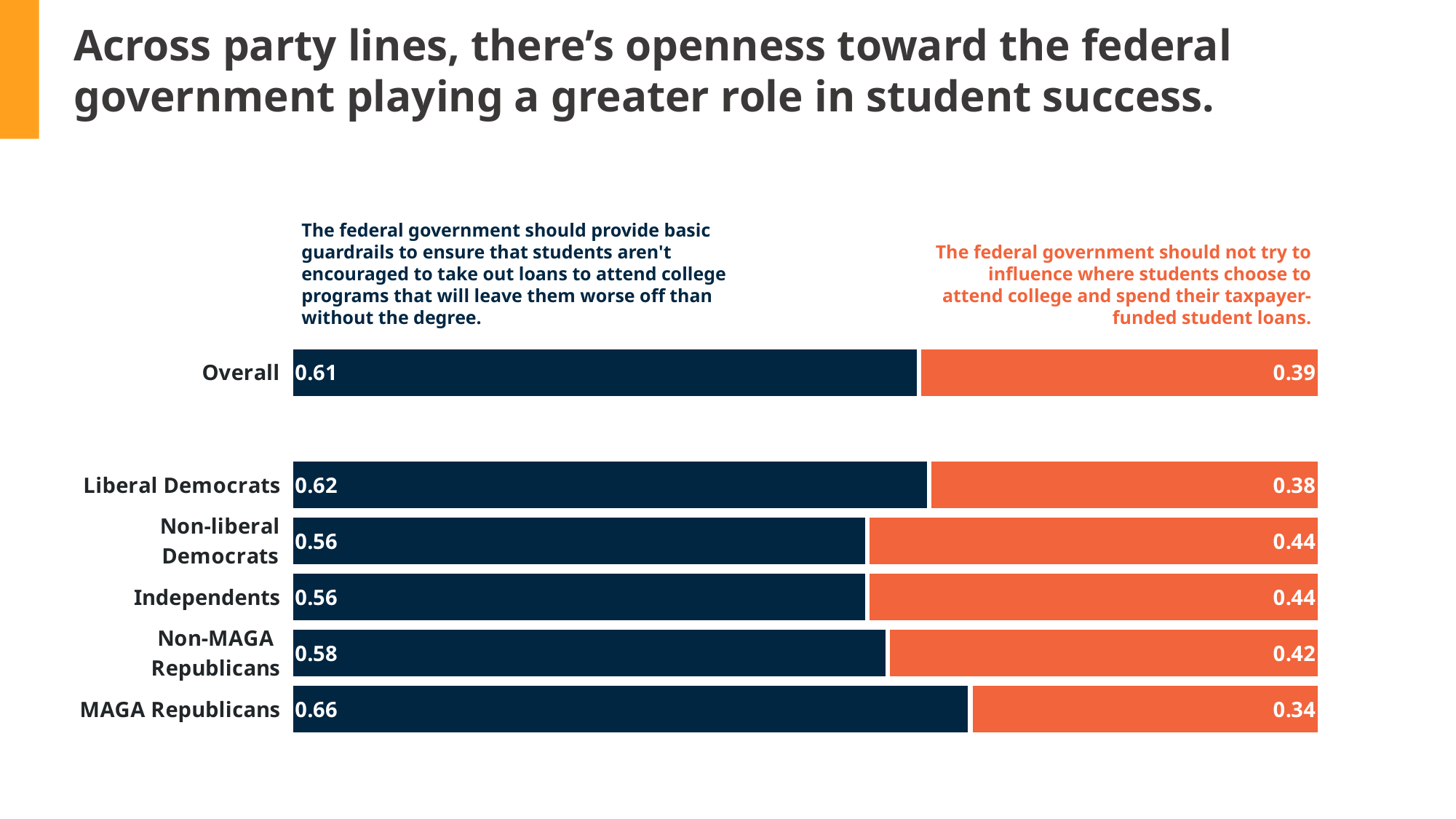
What is the difference between the dark blue values for MAGA Republicans and Non-liberal Democrats? 0.10 Which group has the lowest value for the orange series (the federal government should not try to influence where students choose to attend college)? MAGA Republicans What is the total of the stacked bar for Independents? 1.00 What is the value for MAGA Republicans for the orange series (the federal government should not try to influence where students choose to attend college)? 0.34 What is the value for Non-MAGA Republicans for the dark blue series (the federal government should provide basic guardrails)? 0.58 How many series does the chart show? 2 What kind of chart is shown on the slide? Stacked bar chart What is the value for Liberal Democrats for the orange series (the federal government should not try to influence where students choose to attend college)? 0.38 How many groups (categories) are shown in the chart? 6 Which is larger: the dark blue value for Liberal Democrats or the dark blue value for Independents? Liberal Democrats What is the value for Overall for the dark blue series (the federal government should provide basic guardrails)? 0.61 Which group has the highest value for the dark blue series (the federal government should provide basic guardrails)? MAGA Republicans